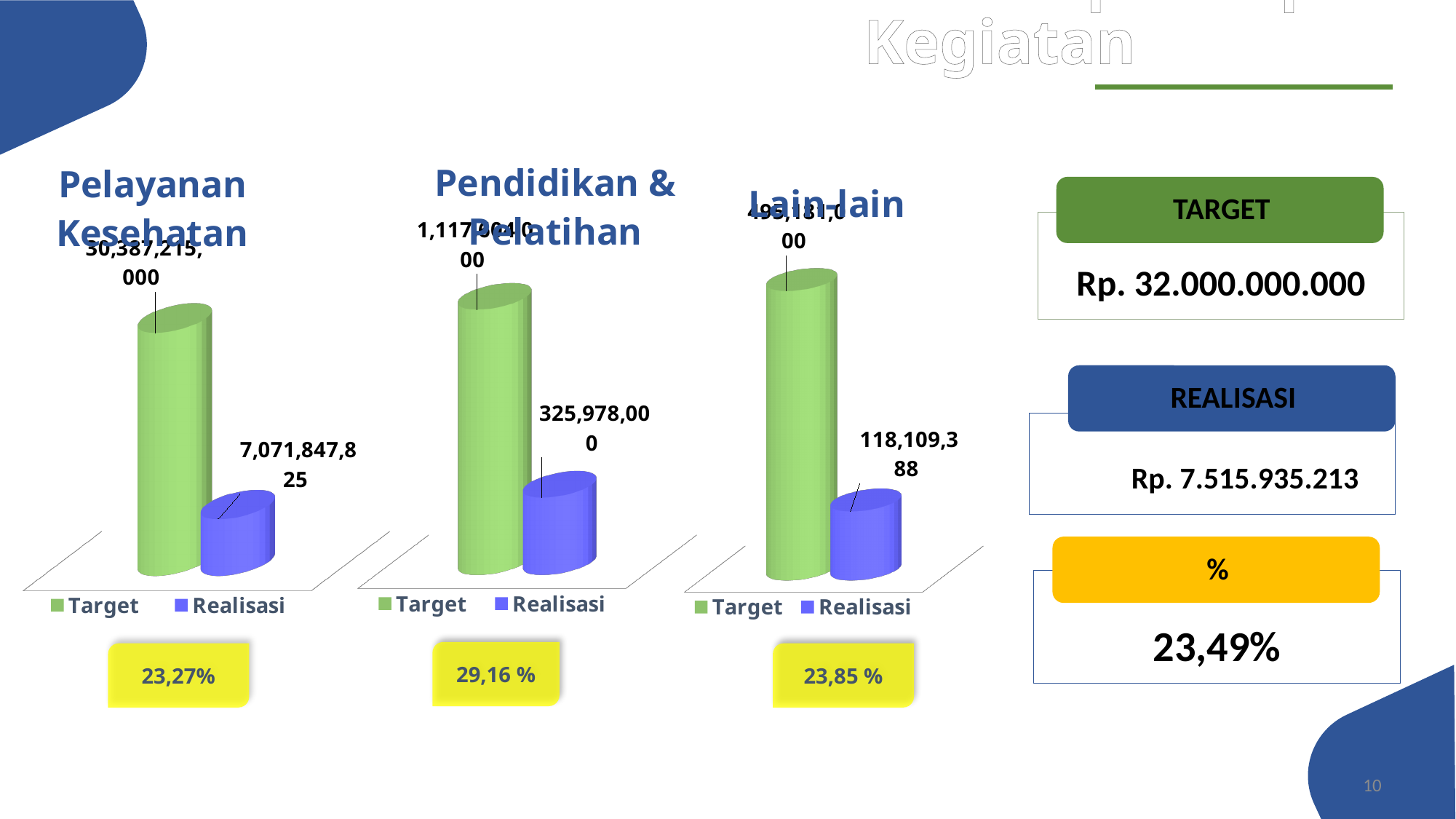
In the Pendidikan & Pelatihan chart, what is the value of the Realisasi bar? 325,978,000 Which of the three charts shows the highest Realisasi value? Pelayanan Kesehatan In the Pelayanan Kesehatan chart, which is larger, Target or Realisasi? Target How many bars are plotted in the Lain-lain chart? 2 In the Lain-lain chart, what is the value of the Realisasi bar? 118,109,388 What is the difference between the Realisasi value in the Pendidikan & Pelatihan chart and the Realisasi value in the Lain-lain chart? 207,868,612 In the Lain-lain chart, which is larger, Target or Realisasi? Target How many series does the legend of the Pendidikan & Pelatihan chart list? 2 What are the two legend entries in the Pelayanan Kesehatan chart? Target and Realisasi What kind of chart is the Pelayanan Kesehatan chart? bar chart Which of the three charts shows the lowest Realisasi value? Lain-lain In the Pelayanan Kesehatan chart, what is the value of the Realisasi bar? 7,071,847,825